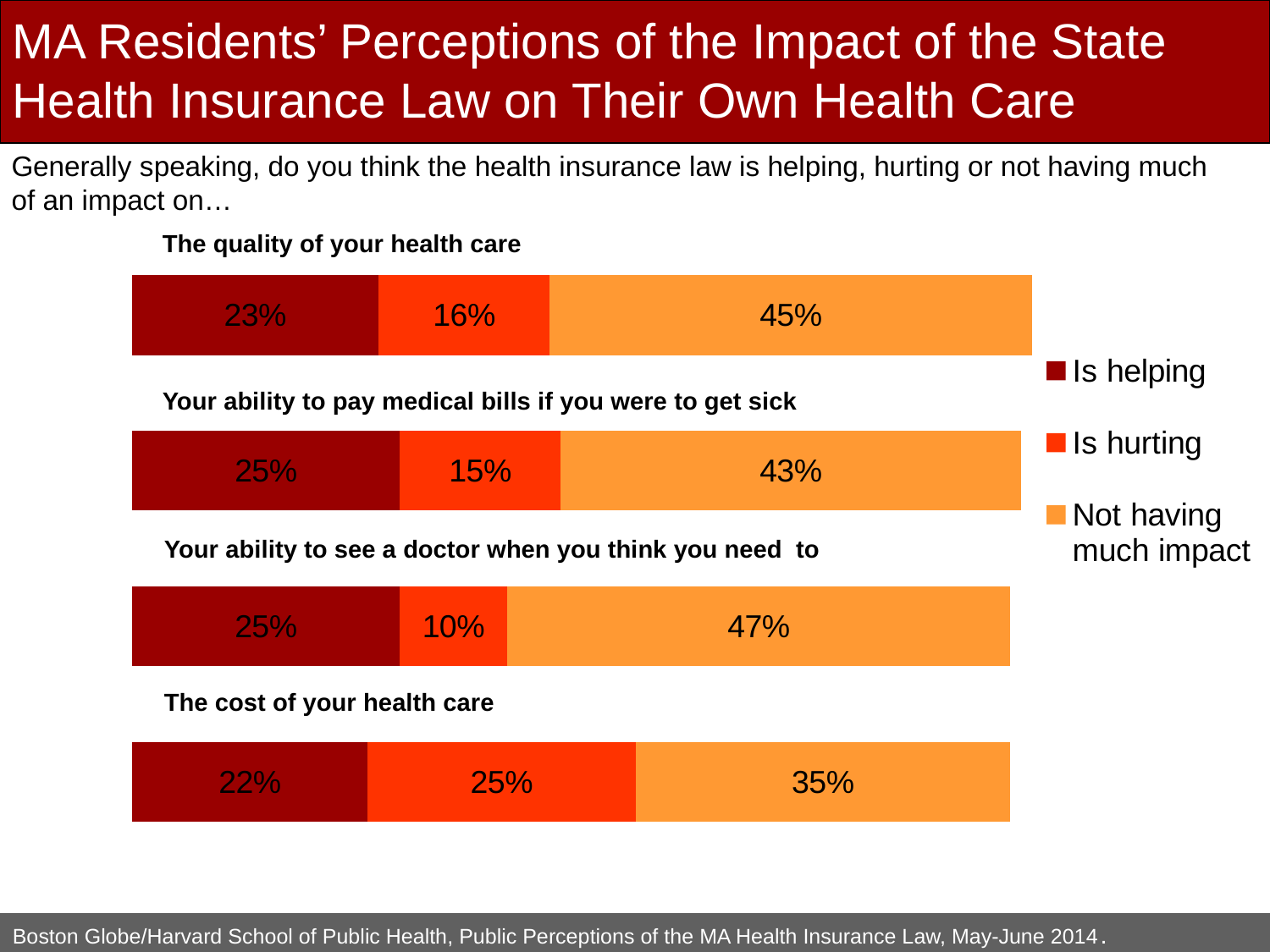
What percentage say the law is hurting their ability to pay medical bills if they were to get sick? 15% How many series does the legend list? 3 What percentage of MA residents say the law is helping the quality of their health care? 23% What is the difference between the 'Not having much impact' share for the quality of your health care and for the cost of your health care? 10 percentage points For which item is the 'Is hurting' share the lowest? Your ability to see a doctor when you think you need to For which item is the 'Is hurting' share the highest? The cost of your health care What percentage say the law is hurting the cost of their health care? 25% What percentage say the law is not having much impact on their ability to see a doctor when they think they need to? 47% What is the total of the three labeled segments in the bar for the cost of your health care? 82% For which item is the 'Not having much impact' share the lowest? The cost of your health care Which is larger: the 'Is helping' share for the cost of your health care or for the quality of your health care? The quality of your health care How many items (bars) are shown in the chart? 4